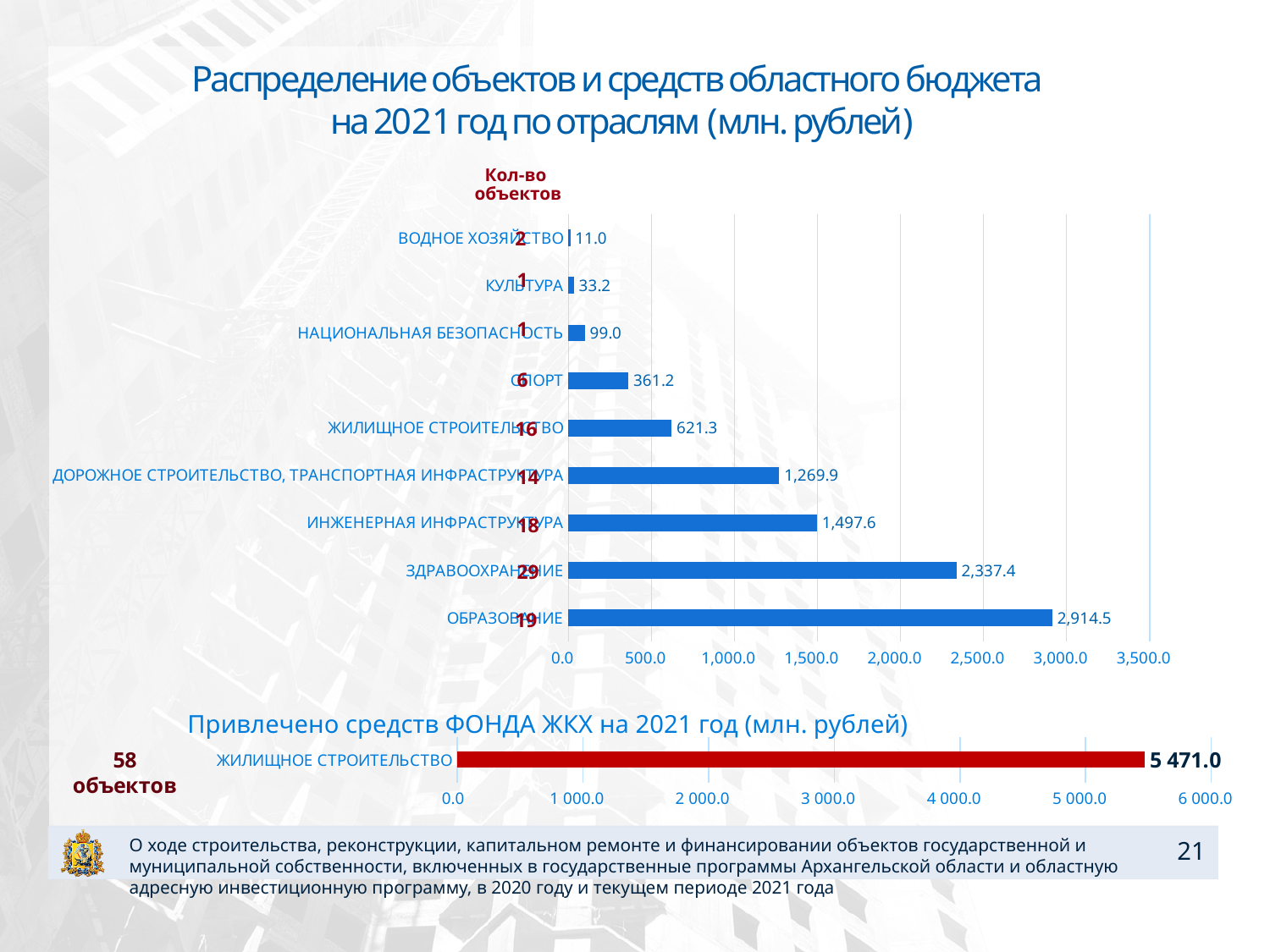
In the top chart, what is the value for СПОРТ? 361.2 In the bottom chart, what is the value for ЖИЛИЩНОЕ СТРОИТЕЛЬСТВО? 5 471.0 What kind of chart is the top chart? Bar chart In the top chart, which category has the lowest value? ВОДНОЕ ХОЗЯЙСТВО In the top chart, which is larger: the value for ИНЖЕНЕРНАЯ ИНФРАСТРУКТУРА or for ДОРОЖНОЕ СТРОИТЕЛЬСТВО, ТРАНСПОРТНАЯ ИНФРАСТРУКТУРА? ИНЖЕНЕРНАЯ ИНФРАСТРУКТУРА In the top chart, what is the value for ОБРАЗОВАНИЕ? 2,914.5 In the top chart, what is the difference between the values for ОБРАЗОВАНИЕ and ЗДРАВООХРАНЕНИЕ? 577.1 What is the title of the bottom chart? Привлечено средств ФОНДА ЖКХ на 2021 год (млн. рублей) In the bottom chart, is the value for ЖИЛИЩНОЕ СТРОИТЕЛЬСТВО greater or less than 5 000.0? greater In the top chart, which category has the highest value? ОБРАЗОВАНИЕ In the top chart, what is the value for ЗДРАВООХРАНЕНИЕ? 2,337.4 In the top chart, how many categories are shown? 9